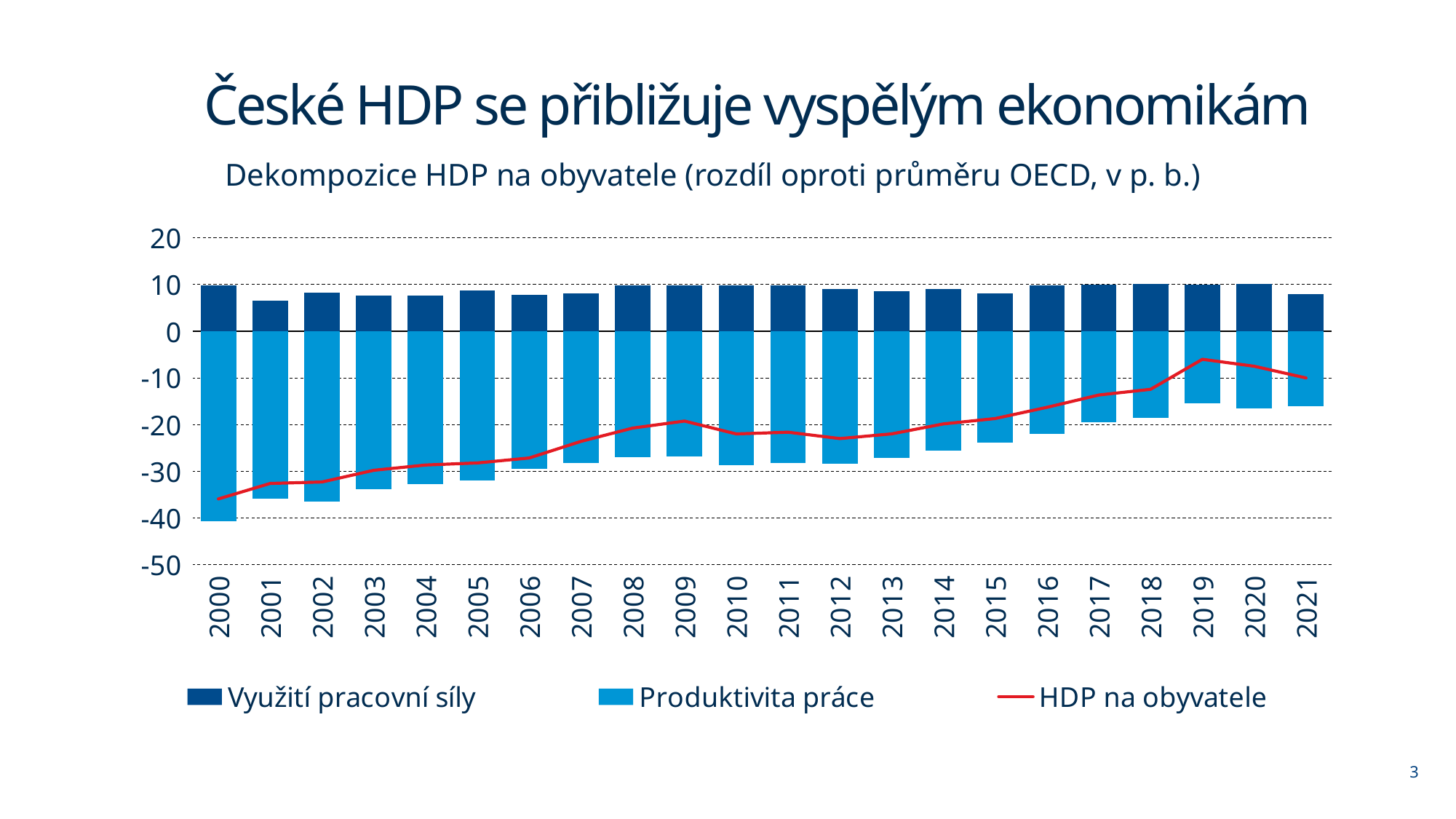
Which year has the larger HDP na obyvatele value, 2019 or 2021? 2019 How many series does the legend list? 3 In which year is the HDP na obyvatele line at its highest? 2019 How many years are shown on the x axis? 22 What kind of chart is shown on the slide? A bar chart combined with a line In which year is the HDP na obyvatele line at its lowest? 2000 Is the Produktivita práce value for 2000 greater or less than -30? less Is the HDP na obyvatele value for 2019 greater or less than -10? greater In which year is the Produktivita práce bar the most negative? 2000 Is the Využití pracovní síly value for 2001 greater or less than 10? less Does the HDP na obyvatele line generally rise or fall from 2000 to 2021? rise